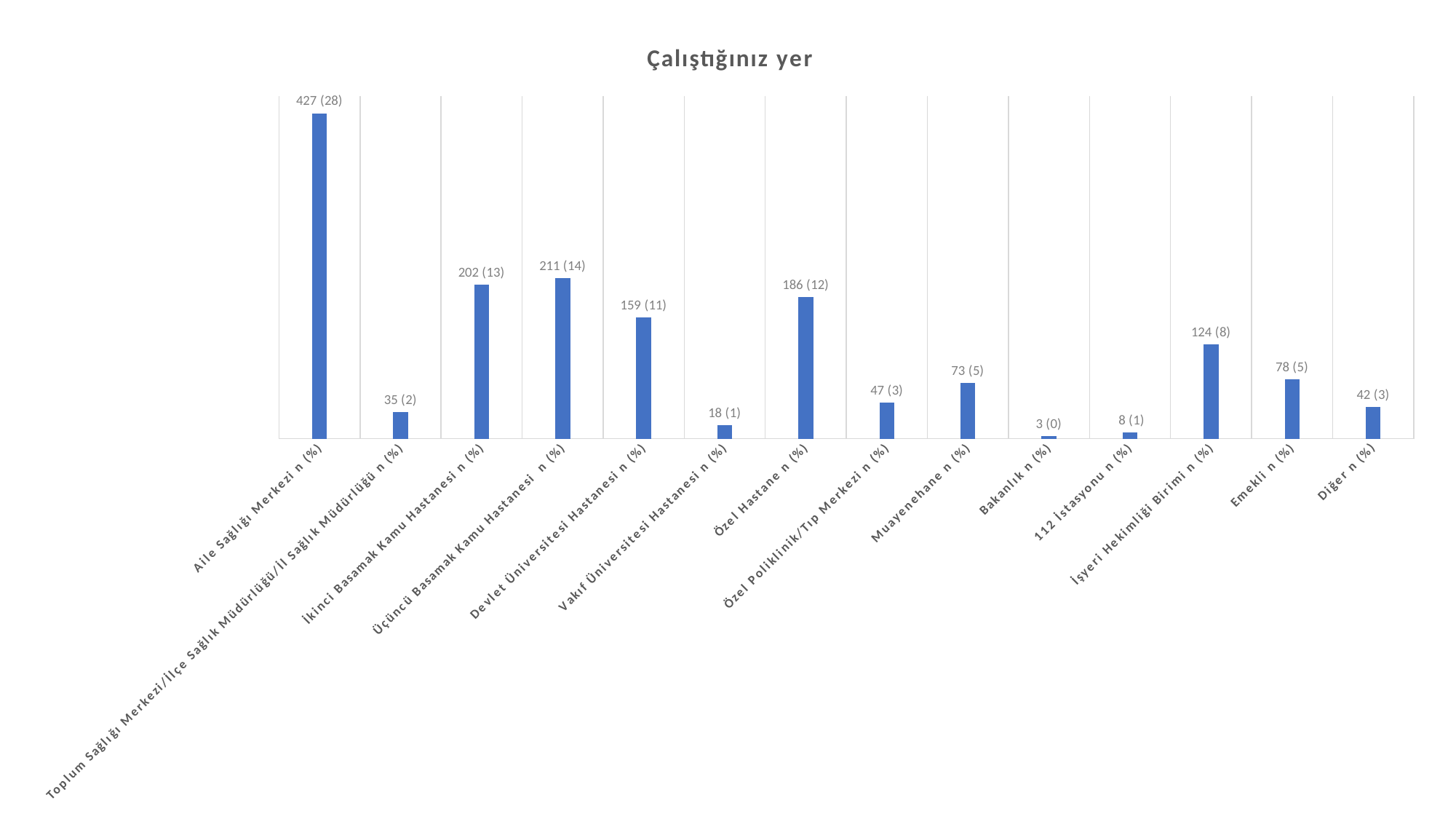
What is the title of the chart? Çalıştığınız yer What is the difference in n between Aile Sağlığı Merkezi and Özel Hastane? 241 Which category has the lowest value? Bakanlık What is the data label for Aile Sağlığı Merkezi? 427 (28) What is the difference in n between Üçüncü Basamak Kamu Hastanesi and İkinci Basamak Kamu Hastanesi? 9 Which has a larger value, Devlet Üniversitesi Hastanesi or Muayenehane? Devlet Üniversitesi Hastanesi What kind of chart is this? Bar chart What is the data label for Emekli? 78 (5) How many categories are shown on the x axis? 14 What is the data label for İşyeri Hekimliği Birimi? 124 (8) Which category has the highest value? Aile Sağlığı Merkezi What is the data label for Özel Hastane? 186 (12)